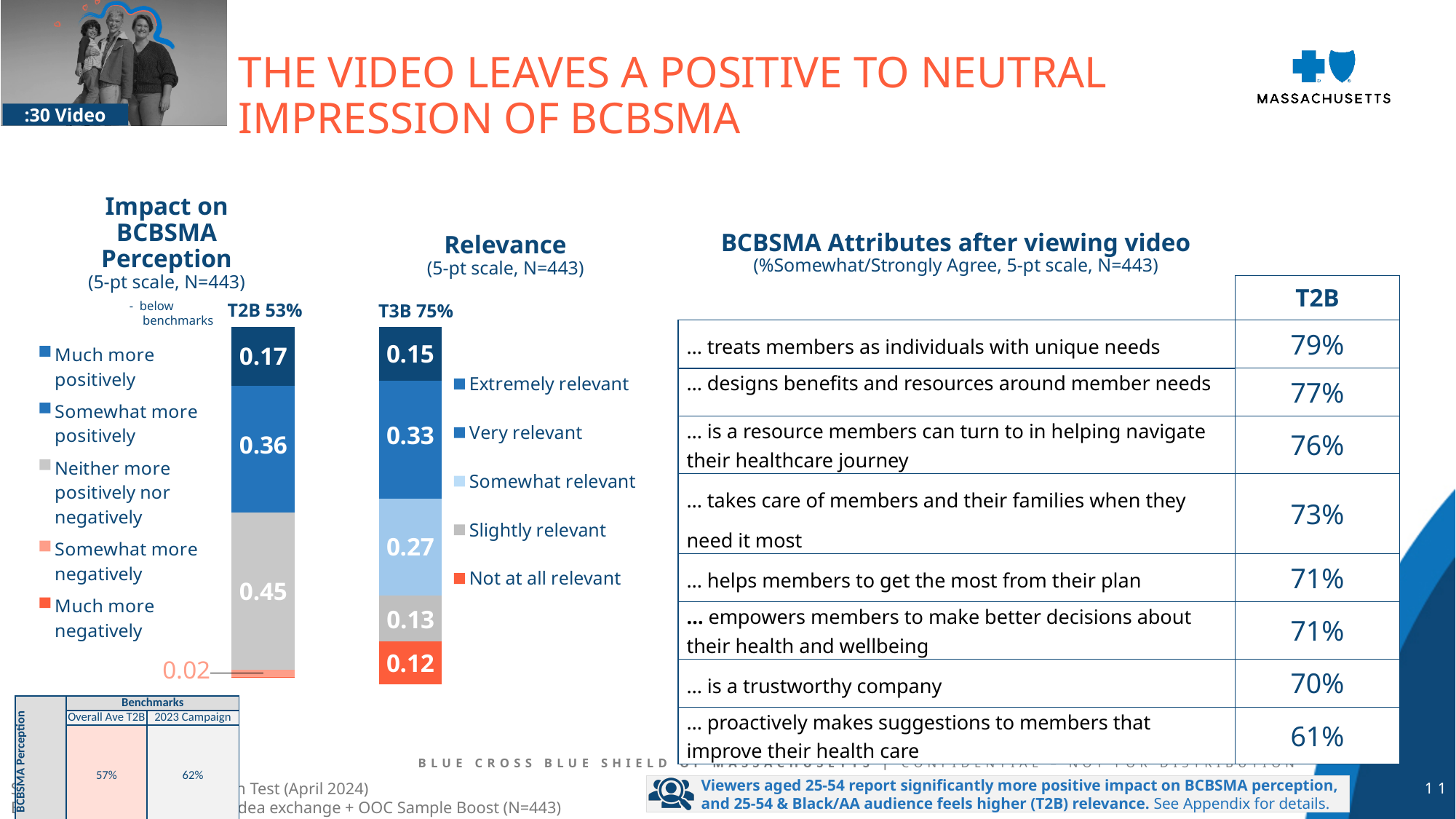
How many entries does the legend of the Impact on BCBSMA Perception chart list? 5 In the Relevance chart, what is the difference between "Very relevant" and "Extremely relevant"? 0.18 In the Relevance chart, what is the value for "Somewhat relevant"? 0.27 In the Impact on BCBSMA Perception chart, what is the value for "Somewhat more positively"? 0.36 In the Impact on BCBSMA Perception chart, what T2B percentage is shown above the bar? 53% In the Impact on BCBSMA Perception chart, which is larger: "Much more positively" or "Somewhat more positively"? Somewhat more positively In the Relevance chart, what is the value for "Not at all relevant"? 0.12 In the Impact on BCBSMA Perception chart, what is the value for "Much more positively"? 0.17 In the Impact on BCBSMA Perception chart, which segment has the largest value? Neither more positively nor negatively In the Relevance chart, what is the value for "Very relevant"? 0.33 What kind of chart is the Relevance chart? Stacked bar chart In the Relevance chart, what T3B percentage is shown above the bar? 75%